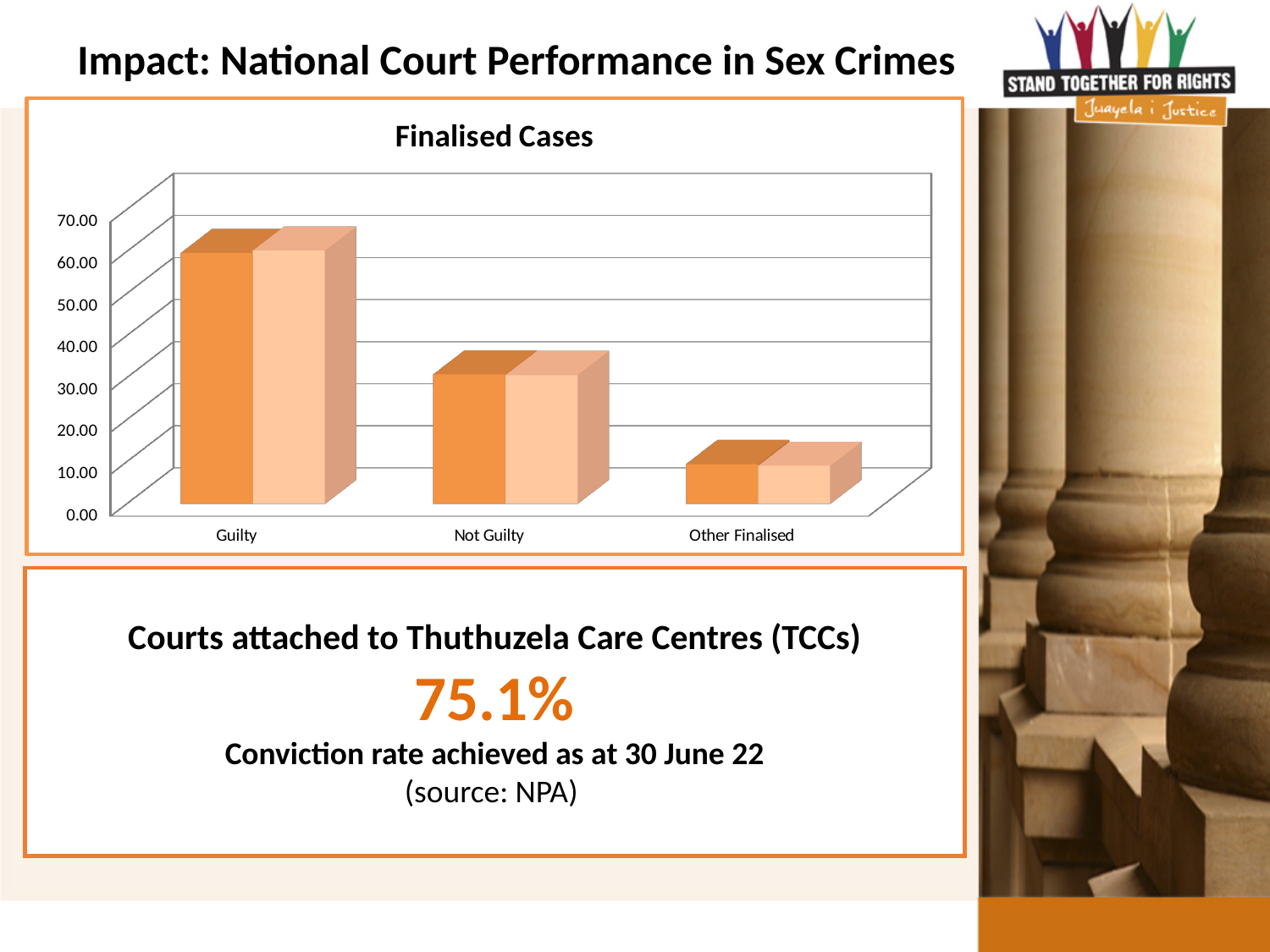
Which category has the highest value in the Finalised Cases chart? Guilty Which is larger in the Finalised Cases chart, Guilty or Not Guilty? Guilty Which category has the lowest value in the Finalised Cases chart? Other Finalised Is the value for Other Finalised greater or less than 20.00? less Which is larger in the Finalised Cases chart, Not Guilty or Other Finalised? Not Guilty What is the highest tick value shown on the vertical axis of the Finalised Cases chart? 70.00 How many categories are shown on the x axis of the Finalised Cases chart? 3 Do the values in the Finalised Cases chart rise or fall from left to right along the x axis? fall What is the title of the chart on the slide? Finalised Cases Is the value for Not Guilty greater or less than 40.00? less Is the value for Guilty greater or less than 50.00? greater What kind of chart is shown on the slide? bar chart